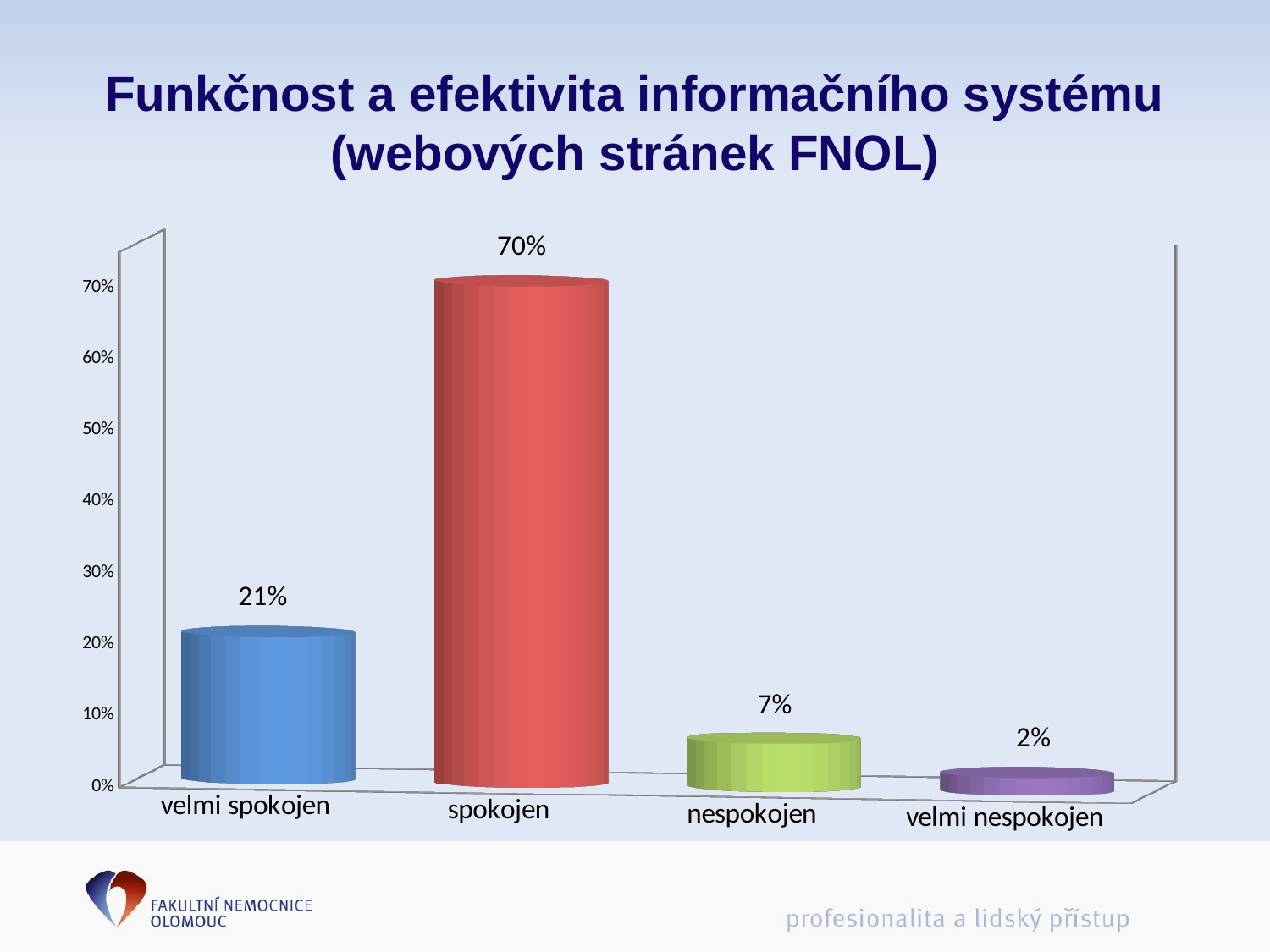
What is the difference between the values for "spokojen" and "velmi spokojen"? 49% What is the value for "velmi spokojen"? 21% What is the value for "spokojen"? 70% What is the difference between the values for "nespokojen" and "velmi nespokojen"? 5% What is the value for "nespokojen"? 7% What is the title of the slide containing the chart? Funkčnost a efektivita informačního systému (webových stránek FNOL) Which category has the highest value? spokojen What kind of chart is shown on the slide? bar chart How many categories are shown on the x axis? 4 Which category has the lowest value? velmi nespokojen What is the value for "velmi nespokojen"? 2% Which is larger, the value for "velmi spokojen" or the value for "nespokojen"? velmi spokojen